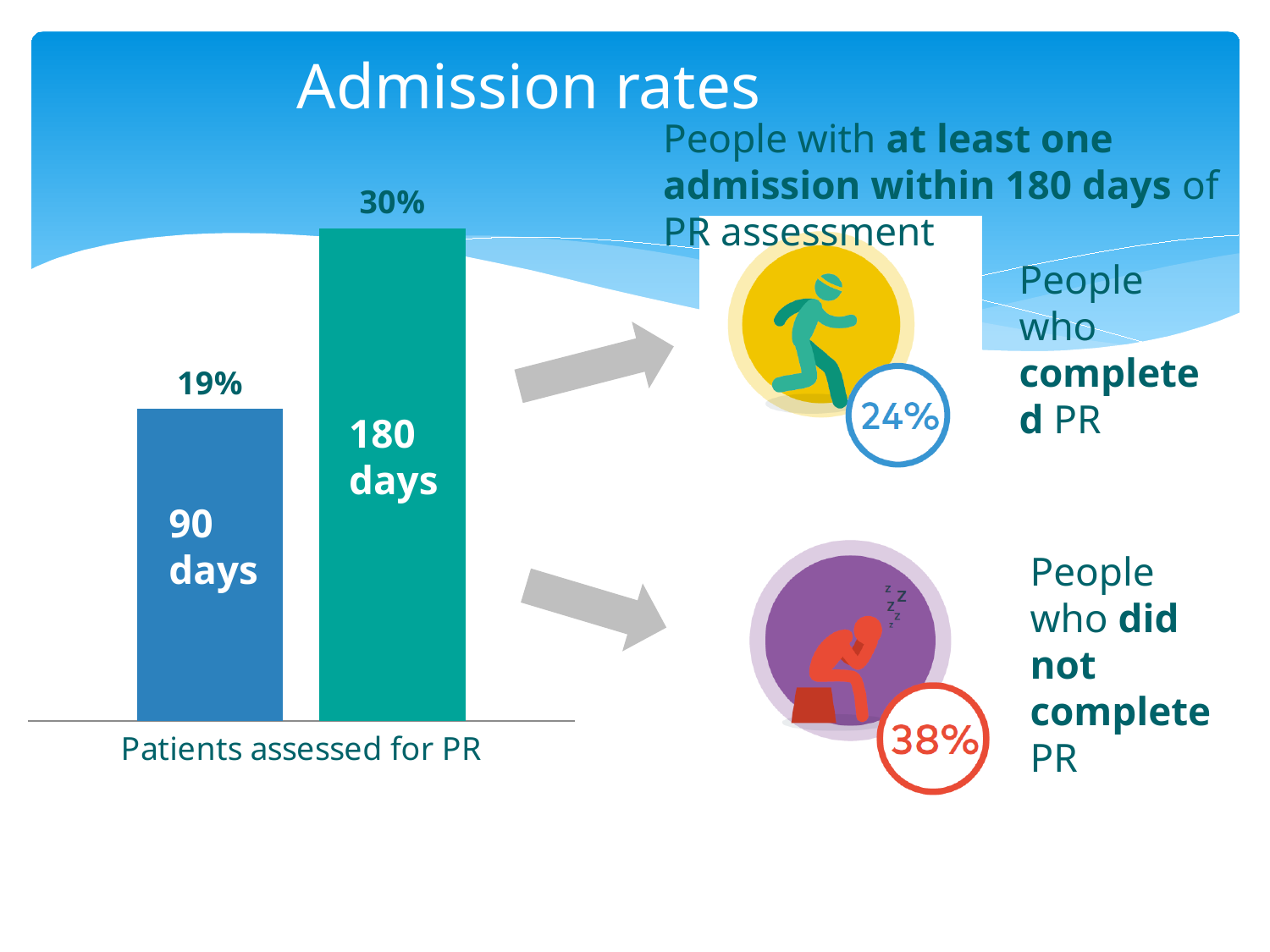
What is the difference between the 180 days and 90 days admission rates? 11% What colour is the 180 days bar? teal/green What is the label below the bars in the chart? Patients assessed for PR Which bar is lower, 90 days or 180 days? 90 days What kind of chart is shown on the slide? bar chart What is the admission rate for 180 days among patients assessed for PR? 30% What percentage of people who did not complete PR had at least one admission within 180 days of PR assessment? 38% Is the 90 days value larger or smaller than the 180 days value? smaller What is the admission rate for 90 days among patients assessed for PR? 19% Which bar is higher, 90 days or 180 days? 180 days How many bars are shown in the chart? 2 What percentage of people who completed PR had at least one admission within 180 days of PR assessment? 24%